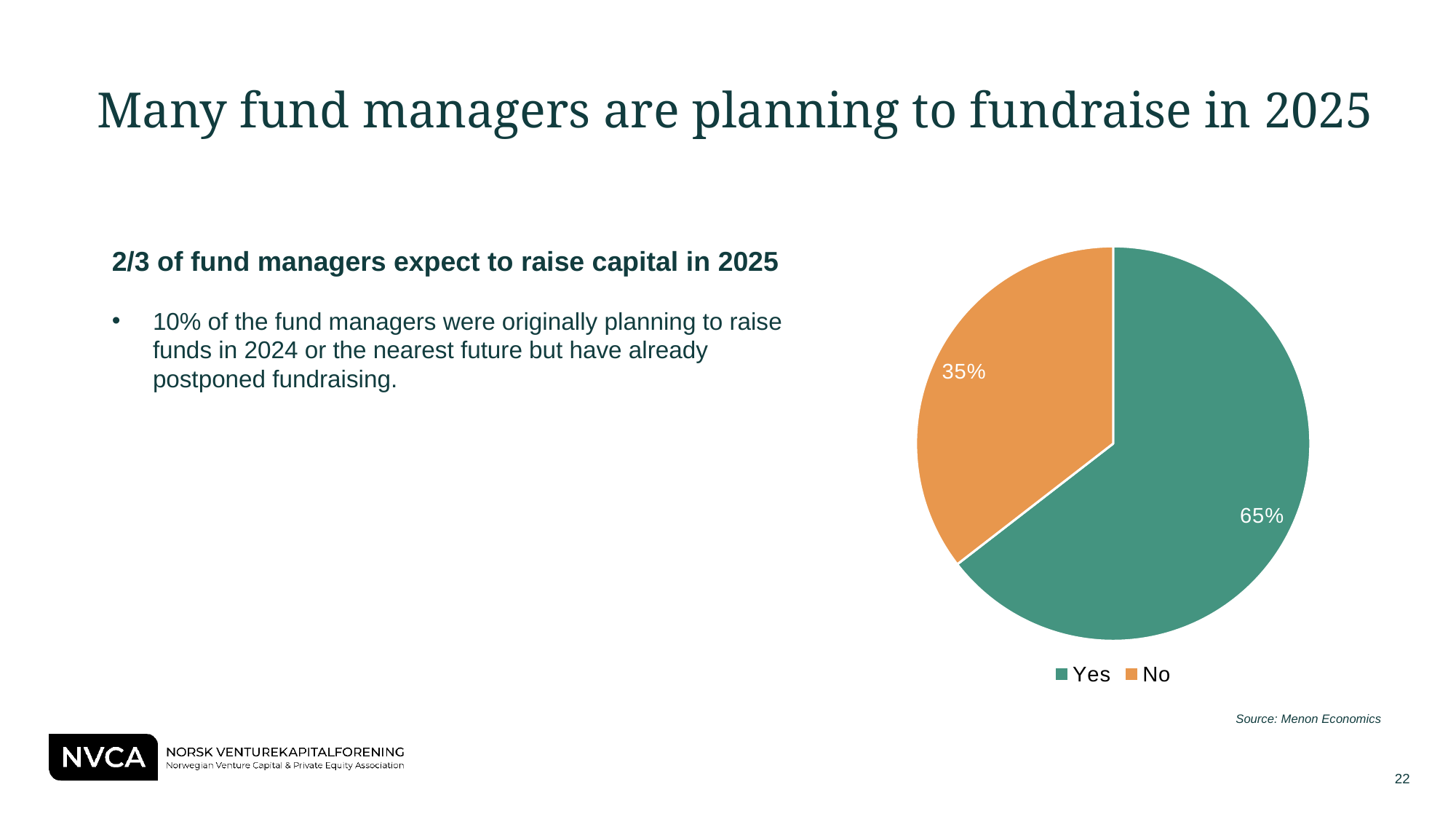
Which slice of the pie is the largest? Yes Which is larger, the "Yes" slice or the "No" slice? Yes How many entries does the legend list? 2 What is the total of the two pie slice percentages? 100% What kind of chart is shown on the slide? pie chart What is the difference in percentage points between the "Yes" and "No" slices? 30 What share of the pie is labelled "Yes"? 65% What share of the pie is labelled "No"? 35% What colour is the "No" slice in the pie chart? orange What colour is the "Yes" slice in the pie chart? green How many slices does the pie chart have? 2 Which slice of the pie is the smallest? No